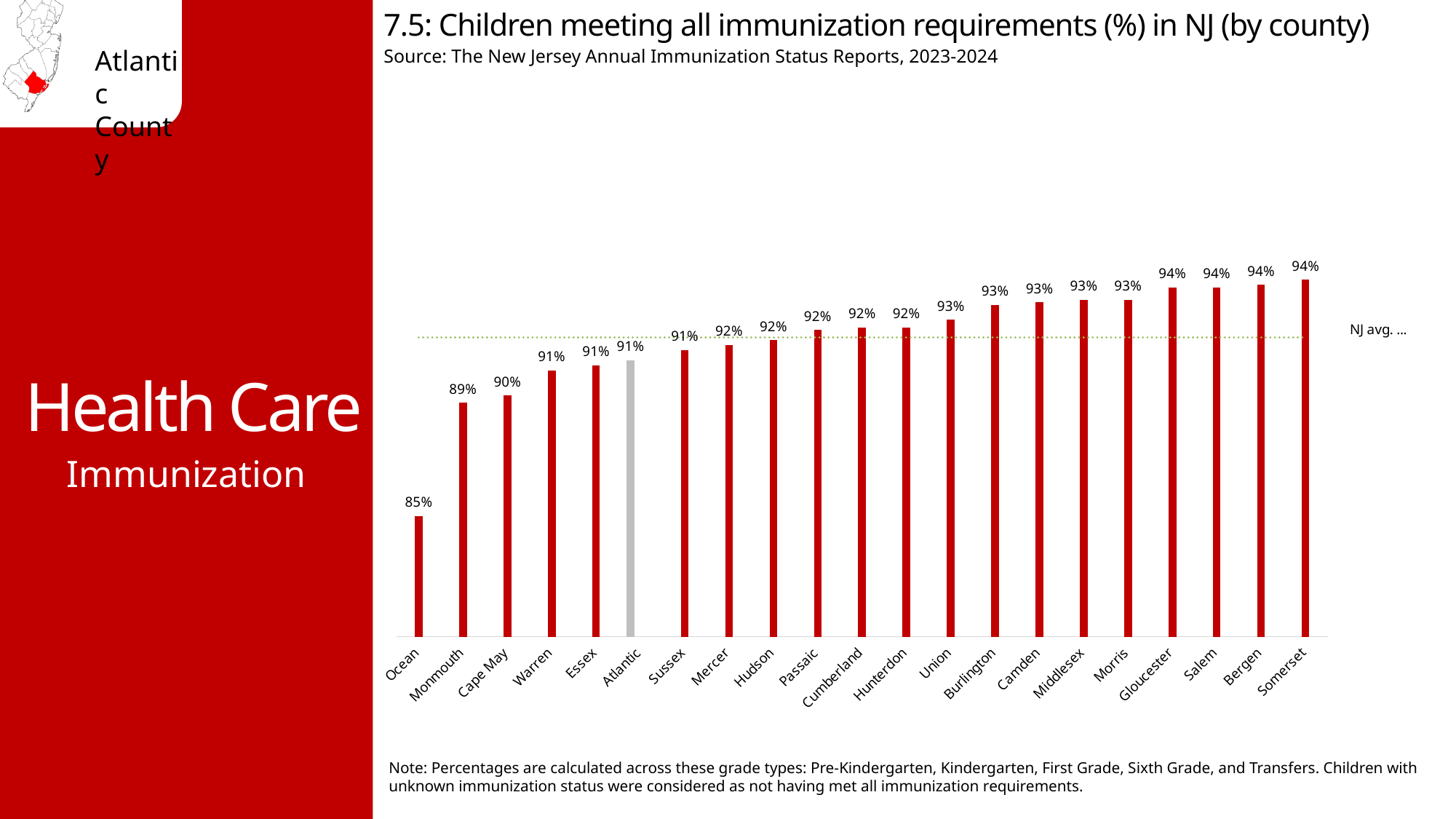
What is the difference in percentage points between Somerset and Ocean? 9 percentage points What percentage of children in Ocean County met all immunization requirements? 85% What is the value for Monmouth County? 89% Which county has the lowest percentage of children meeting all immunization requirements? Ocean Do the values rise or fall from left to right across the counties? Rise Which has a higher value, Atlantic or Somerset? Somerset What kind of chart is used on this slide? Bar chart What is the difference between Atlantic County's value and Ocean County's value? 6 percentage points What is the value shown for Atlantic County? 91% What percentage is shown for Somerset County? 94% Which has a higher value, Ocean or Monmouth? Monmouth How many counties are shown on the chart? 21